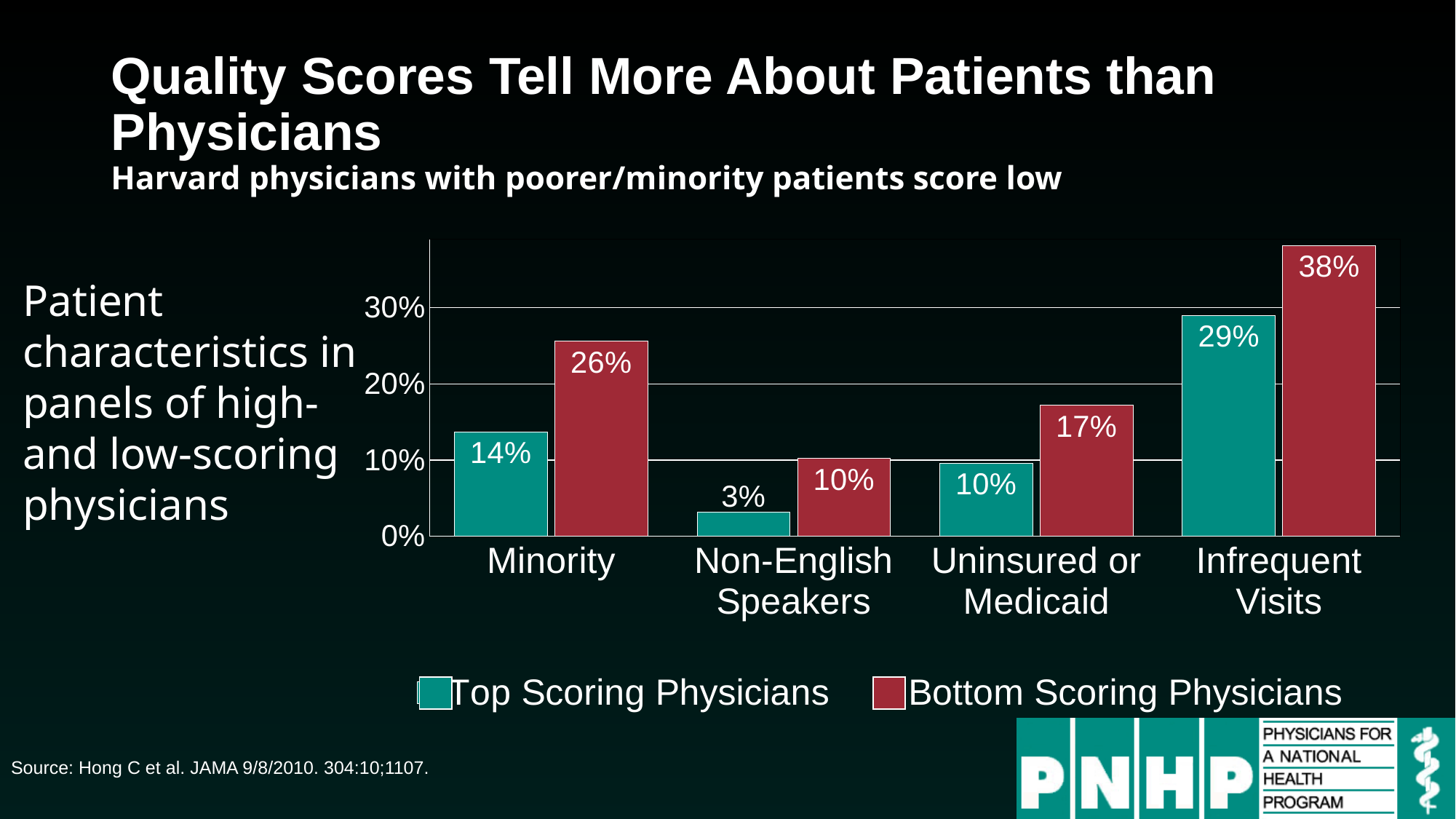
Which category has the highest value for Bottom Scoring Physicians? Infrequent Visits How many series does the legend list? 2 How many categories are shown on the x axis? 4 What is the value for Top Scoring Physicians in the Minority category? 14% What is the value for Bottom Scoring Physicians in the Infrequent Visits category? 38% What is the value for Bottom Scoring Physicians in the Uninsured or Medicaid category? 17% Which category has the lowest value for Top Scoring Physicians? Non-English Speakers What colour are the bars for Bottom Scoring Physicians? Red What is the difference between Bottom Scoring Physicians and Top Scoring Physicians in the Minority category? 12% What is the value for Top Scoring Physicians in the Non-English Speakers category? 3% Which is larger in the Uninsured or Medicaid category: Top Scoring Physicians or Bottom Scoring Physicians? Bottom Scoring Physicians What kind of chart is shown on the slide? Bar chart